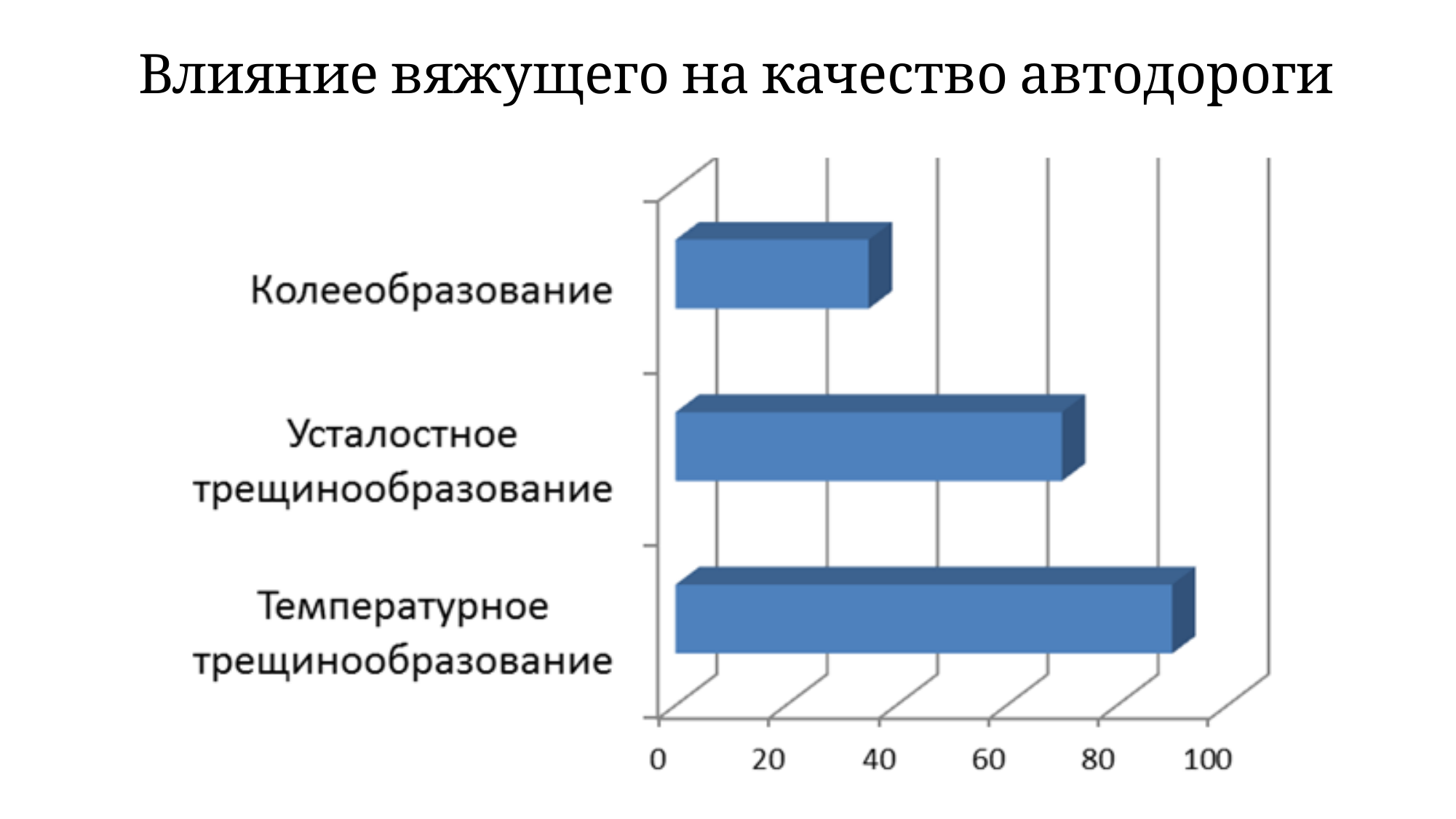
What kind of chart is shown on the slide? bar chart How many categories are plotted in the chart? 3 Is the value for Температурное трещинообразование greater or less than 80? greater Which is larger, the value for Температурное трещинообразование or the value for Усталостное трещинообразование? Температурное трещинообразование Which is larger, the value for Усталостное трещинообразование or the value for Колееобразование? Усталостное трещинообразование Is the value for Колееобразование greater or less than 20? greater Which category has the highest value? Температурное трещинообразование Is the value for Колееобразование greater or less than 60? less What is the highest value shown on the horizontal axis? 100 What is the title of the slide? Влияние вяжущего на качество автодороги Which category has the lowest value? Колееобразование